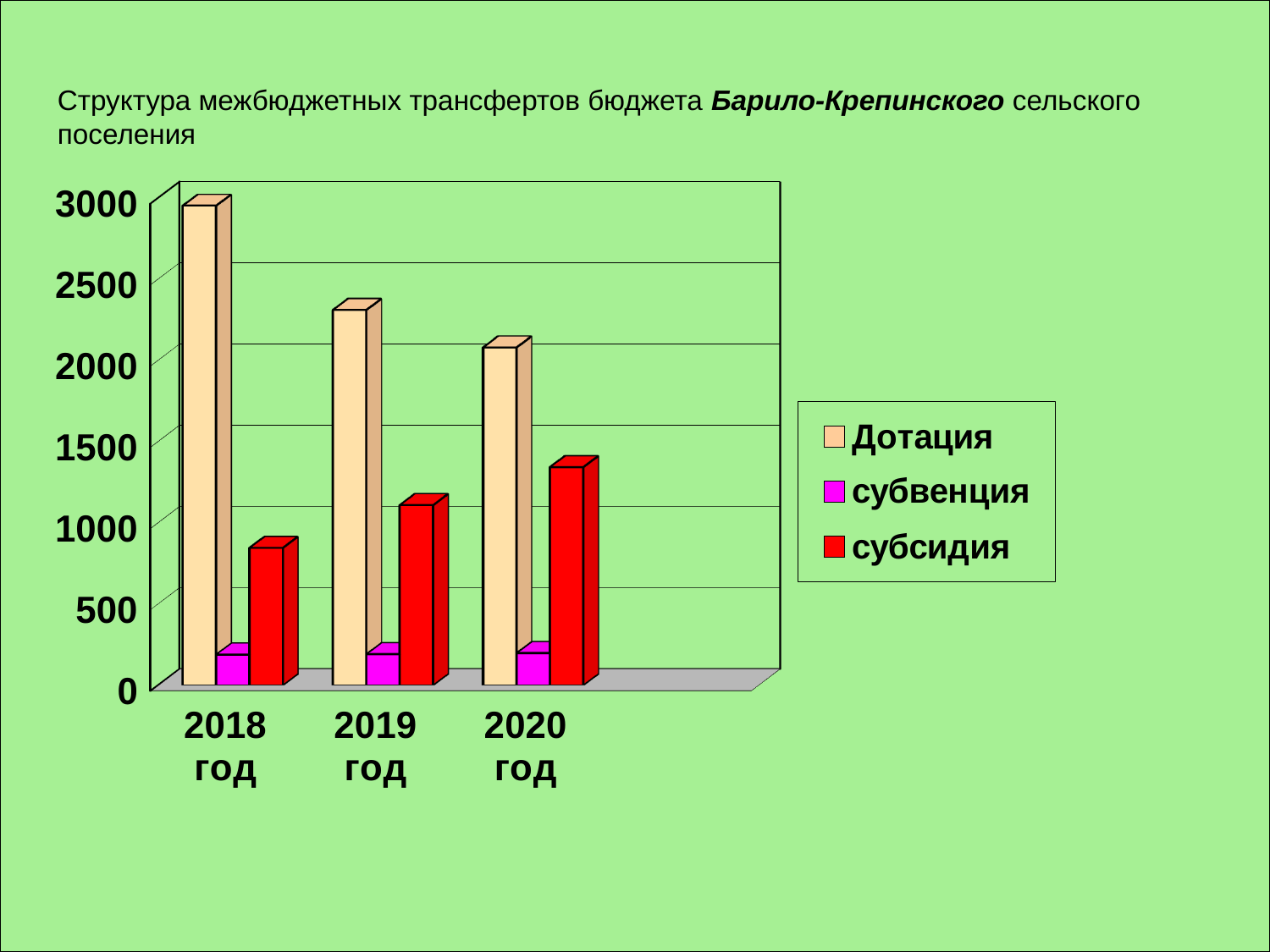
In which year is the Дотация value highest? 2018 год What kind of chart is shown on the slide? bar chart Is the Дотация value for 2019 год greater or less than 2000? greater Which colour represents субсидия in the legend? red Is the субсидия value for 2018 год greater or less than 1000? less How many year categories are shown on the x axis? 3 Which series has the lowest values in every year? субвенция In which year is the субсидия value lowest? 2018 год Which is larger in 2020 год: Дотация or субсидия? Дотация Do the Дотация values rise or fall from 2018 год to 2020 год? fall Is the субсидия value for 2020 год greater or less than 1000? greater How many series does the legend list? 3